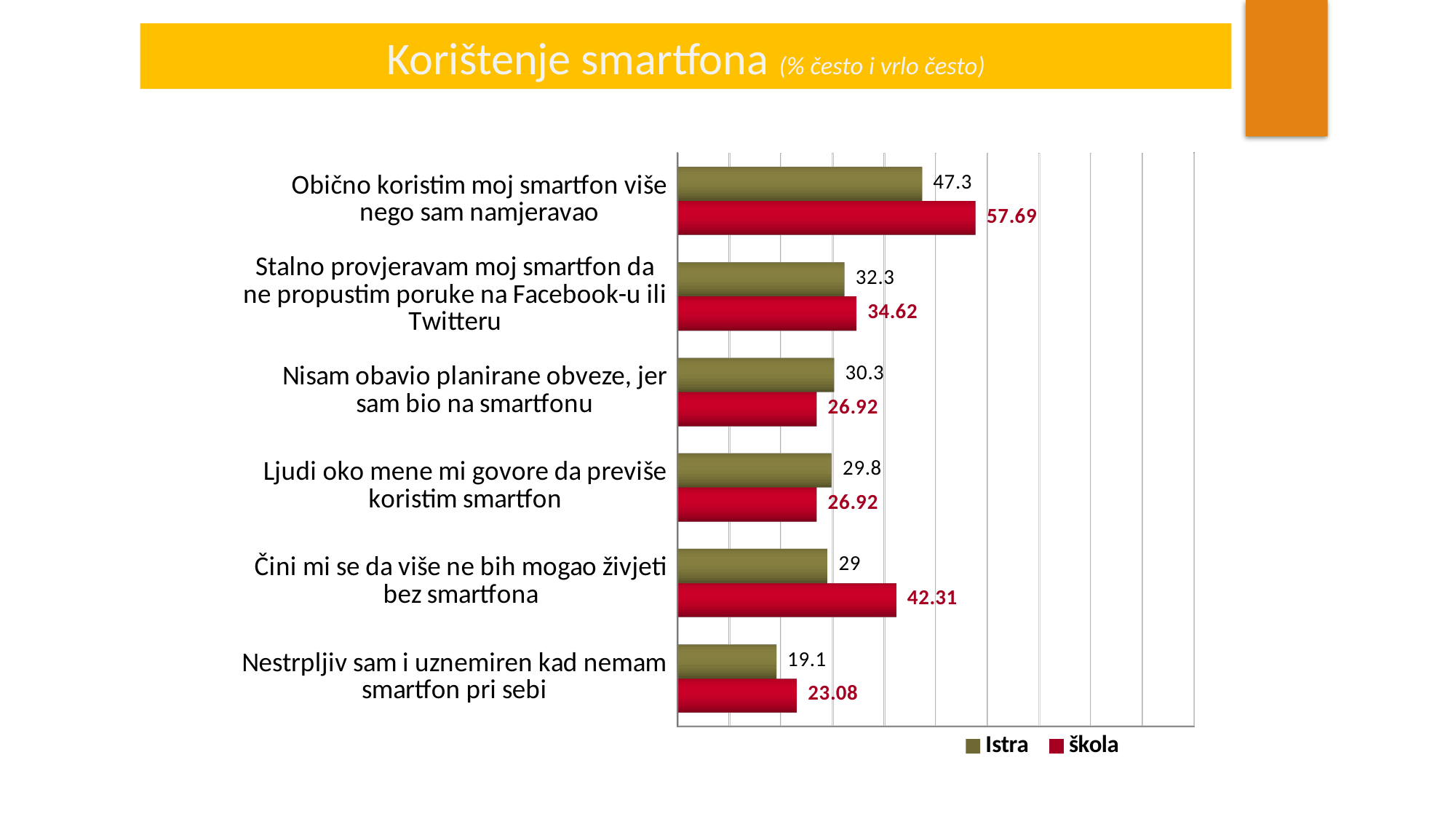
For "Nisam obavio planirane obveze, jer sam bio na smartfonu", which series has the larger value, Istra or škola? Istra What is the škola value for "Nestrpljiv sam i uznemiren kad nemam smartfon pri sebi"? 23.08 What is the title of the slide? Korištenje smartfona (% često i vrlo često) What kind of chart is shown on the slide? Bar chart What is the Istra value for "Stalno provjeravam moj smartfon da ne propustim poruke na Facebook-u ili Twitteru"? 32.3 What is the Istra value for "Obično koristim moj smartfon više nego sam namjeravao"? 47.3 How many categories are shown in the chart? 6 What is the škola value for "Čini mi se da više ne bih mogao živjeti bez smartfona"? 42.31 What is the difference between the škola and Istra values for "Obično koristim moj smartfon više nego sam namjeravao"? 10.39 Which category has the highest škola value? Obično koristim moj smartfon više nego sam namjeravao Which category has the lowest Istra value? Nestrpljiv sam i uznemiren kad nemam smartfon pri sebi How many series does the legend list? 2